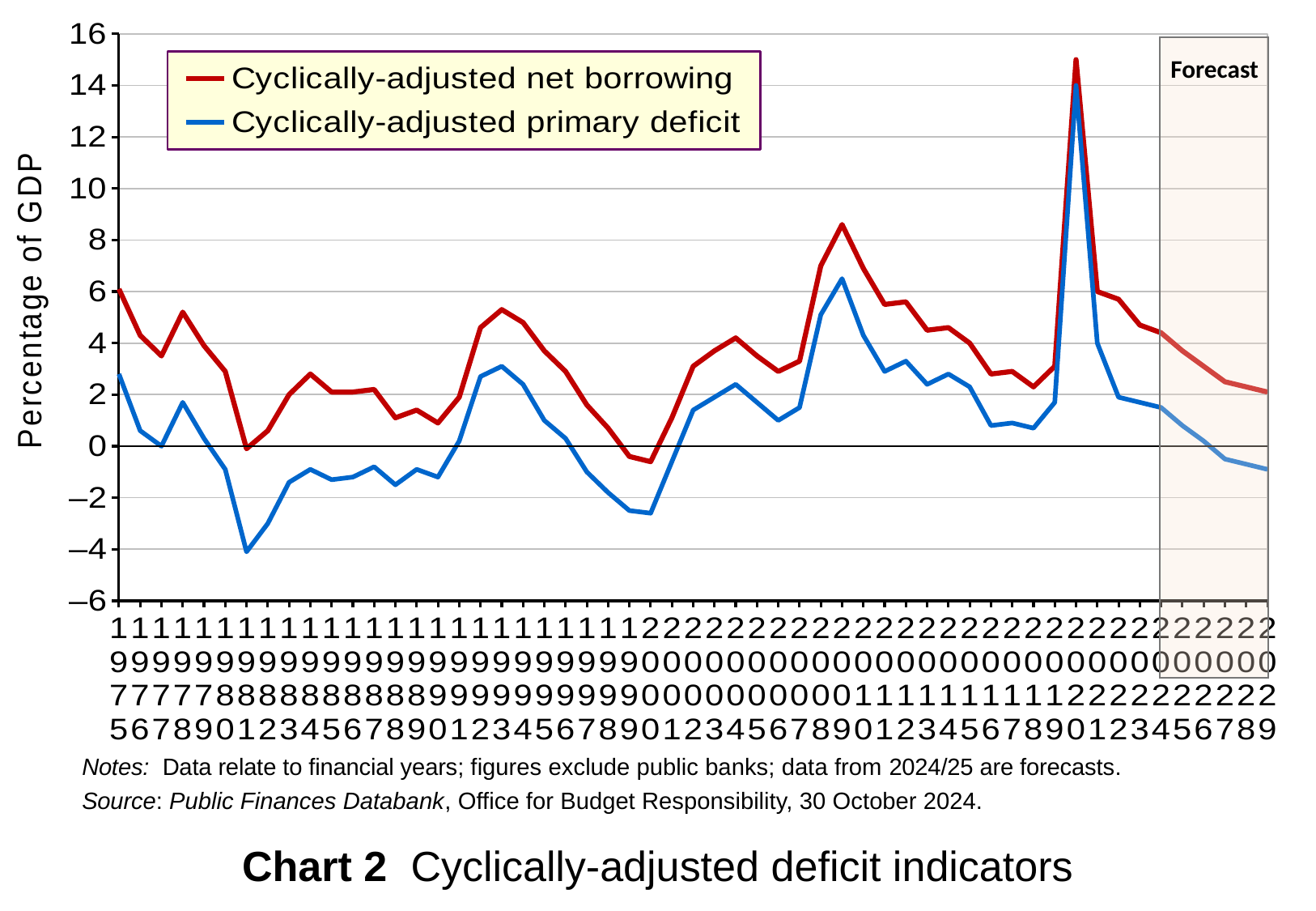
How many series does the legend list? 2 Is the value for the cyclically-adjusted primary deficit in 1981 greater or less than -2? less Is the value for the cyclically-adjusted primary deficit in 2029 greater or less than 0? less Is the value for cyclically-adjusted net borrowing in 2020 greater or less than 14? greater Which is larger in 2020: cyclically-adjusted net borrowing or the cyclically-adjusted primary deficit? Cyclically-adjusted net borrowing Do the two series rise or fall across the forecast period from 2024 to 2029? fall In which year does the cyclically-adjusted primary deficit reach its lowest value? 1981 What is the label on the vertical axis? Percentage of GDP In which year does cyclically-adjusted net borrowing reach its highest value? 2020 Which series reaches the highest value on the chart? Cyclically-adjusted net borrowing What kind of chart is shown on the slide? line chart